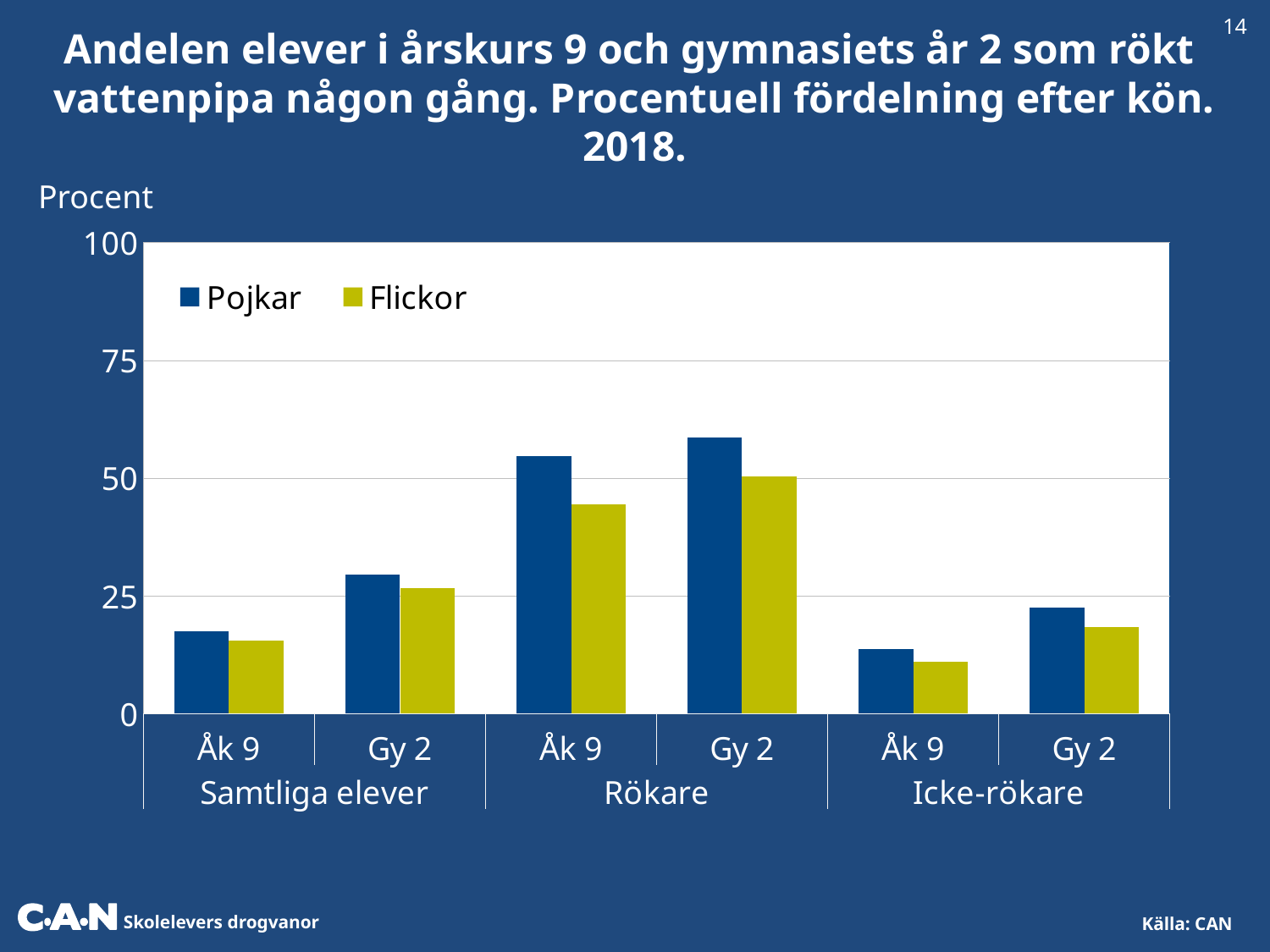
What kind of chart is shown on the slide? bar chart Is the value for Pojkar in Gy 2 among Rökare greater or less than 50? greater Among Rökare in Åk 9, which is larger: Pojkar or Flickor? Pojkar Which bar is the highest in the chart? Pojkar, Gy 2 (Rökare) How many series does the legend list? 2 Which bar is the lowest in the chart? Flickor, Åk 9 (Icke-rökare) How many categories (bar groups) are shown along the x axis? 6 Is the value for Pojkar in Gy 2 among Samtliga elever greater or less than 25? greater Which series is shown in yellow-green? Flickor Among Samtliga elever, which is larger: Pojkar in Gy 2 or Pojkar in Åk 9? Pojkar in Gy 2 Is the value for Flickor in Åk 9 among Icke-rökare greater or less than 25? less